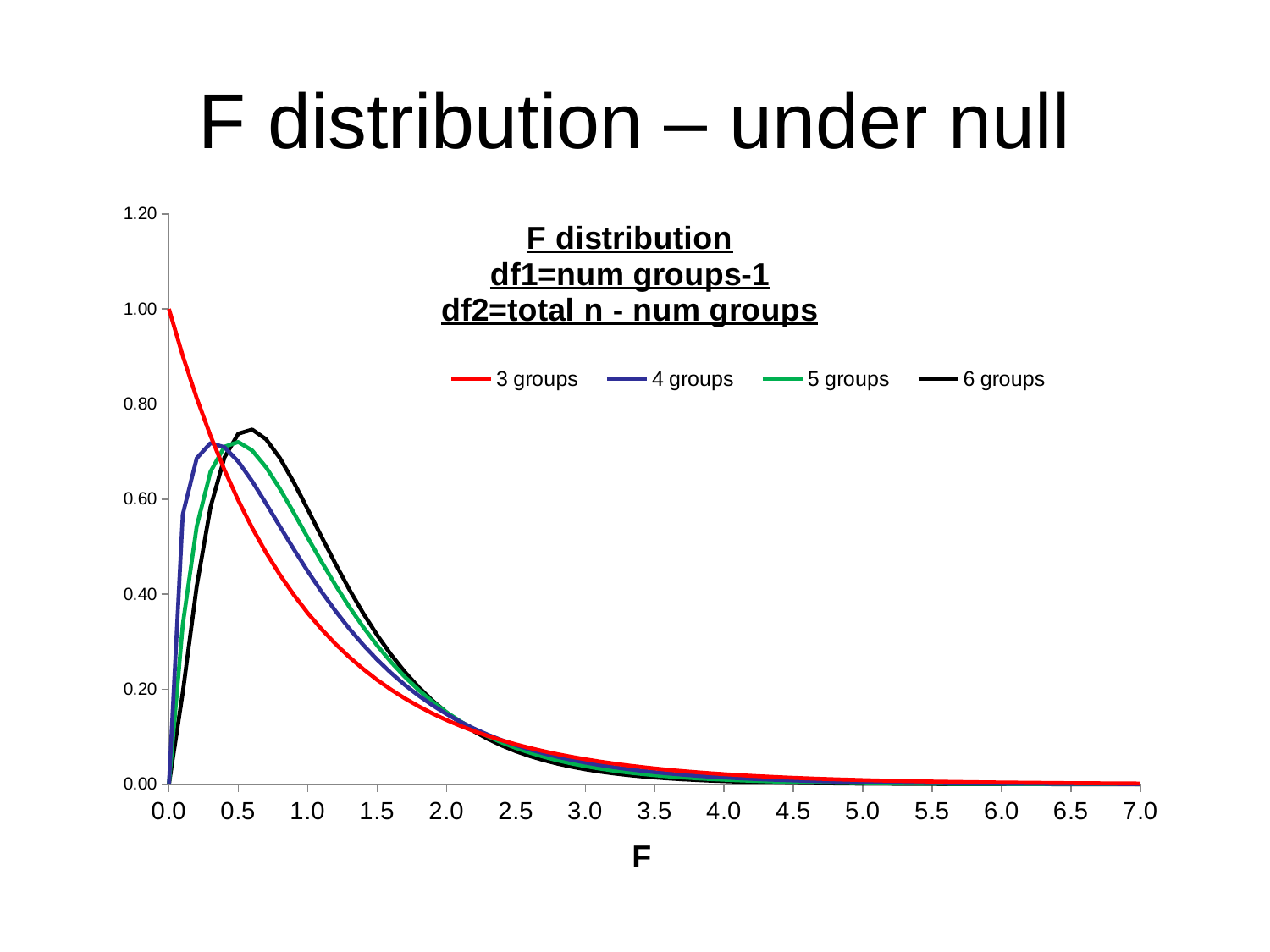
Is the value of the 4 groups series at F = 0.5 greater or less than 0.40? greater Does the 3 groups series rise or fall as F increases? fall What is the highest value shown on the y axis? 1.20 At F = 1.0, which series has the larger value, 6 groups or 3 groups? 6 groups Is the peak value of the 6 groups series greater or less than 0.60? greater What colour is the line for the 5 groups series? green Is the value of the 3 groups series at F = 2.0 greater or less than 0.20? less How many series does the legend list? 4 What is the value of the 3 groups series at F = 0.0? 1.00 What kind of chart is shown on the slide? line chart What is the label of the x axis? F Which series has the highest value at F = 0.0? 3 groups